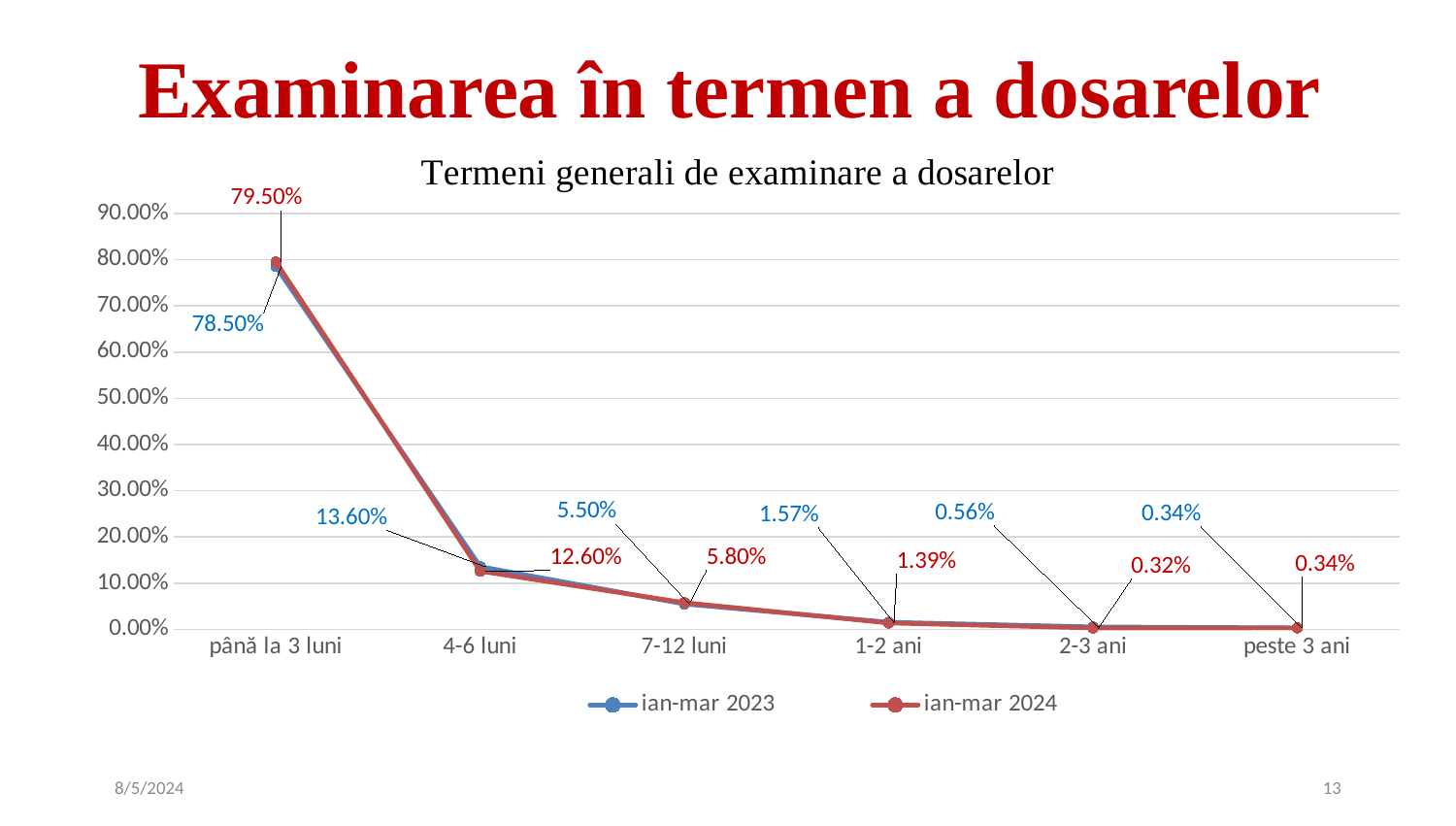
How many categories are shown on the x axis? 6 Which series has the larger value for '7-12 luni', ian-mar 2023 or ian-mar 2024? ian-mar 2024 Do the values for ian-mar 2023 rise or fall from 'până la 3 luni' to 'peste 3 ani'? fall What is the value for ian-mar 2023 in the category '4-6 luni'? 13.60% What kind of chart is shown on the slide? line chart How many series does the legend list? 2 What is the title of the chart? Termeni generali de examinare a dosarelor Which category has the highest value for ian-mar 2023? până la 3 luni What is the value for ian-mar 2024 in the category 'până la 3 luni'? 79.50% Which category has the lowest value for ian-mar 2024? 2-3 ani What is the difference between the ian-mar 2024 and ian-mar 2023 values for 'până la 3 luni'? 1.00% What is the value for ian-mar 2024 in the category '1-2 ani'? 1.39%